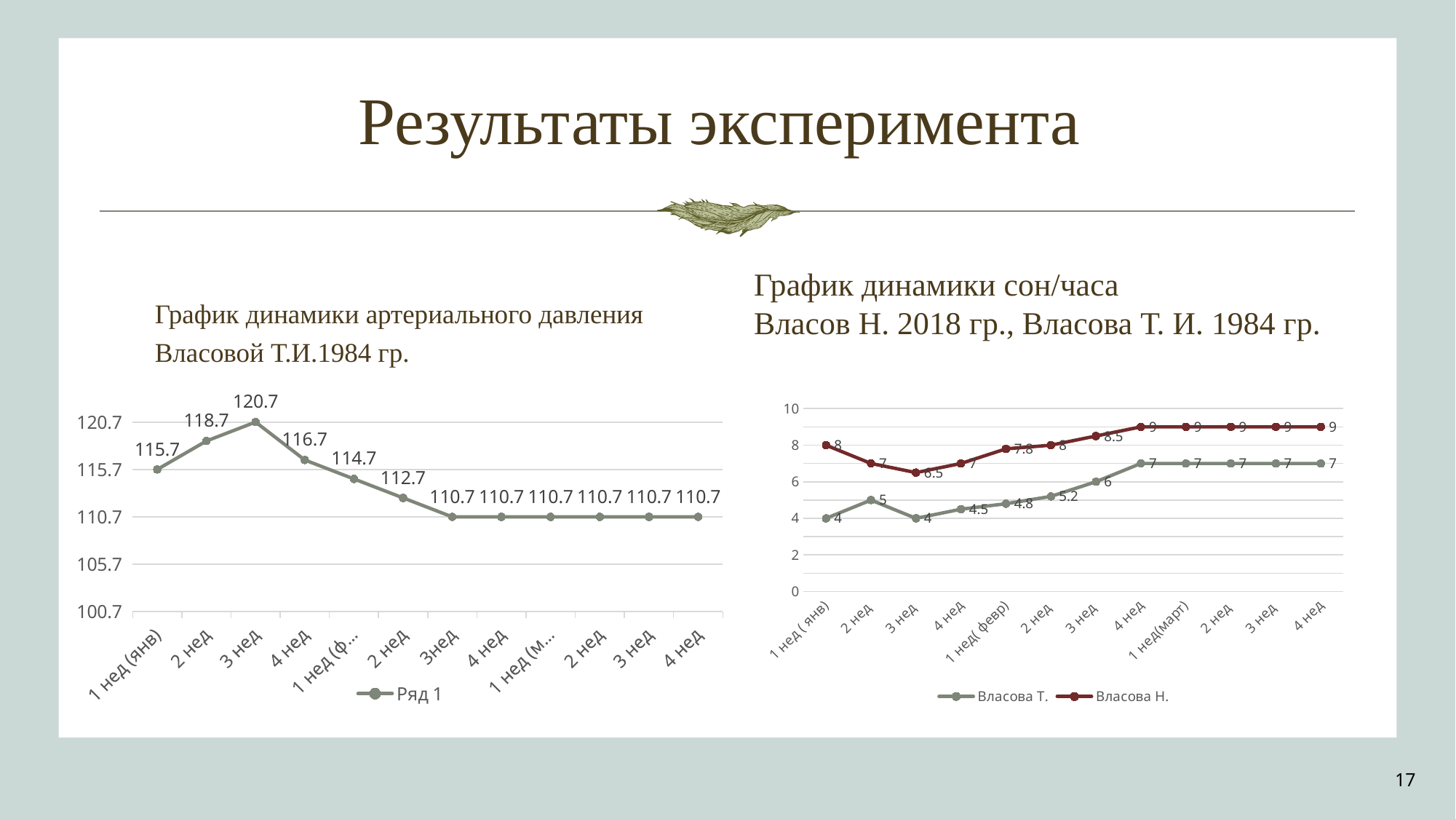
In the right chart (sleep hours), what is the difference between Власова Н. and Власова Т. at 4 нед (март)? 2 In the left chart (blood pressure), what is the value for 1 нед (янв)? 115.7 In the left chart (blood pressure), which point has the highest value? 3 нед In the left chart (blood pressure), what is the value for 3 нед (the third point)? 120.7 In the right chart (sleep hours), how many series does the legend list? 2 In the left chart (blood pressure), how many data points are plotted? 12 In the right chart (sleep hours), what is the value for Власова Т. at 1 нед (февр)? 4.8 In the left chart (blood pressure), what is the difference between the highest value (120.7) and the first value (115.7)? 5 In the right chart (sleep hours), what is the value for Власова Н. at 3 нед in January? 6.5 In the left chart (blood pressure), what is the name of the series shown in the legend? Ряд 1 In the right chart (sleep hours), which series has the higher value at 1 нед (янв)? Власова Н. What type of chart is the right chart (sleep hours)? Line chart